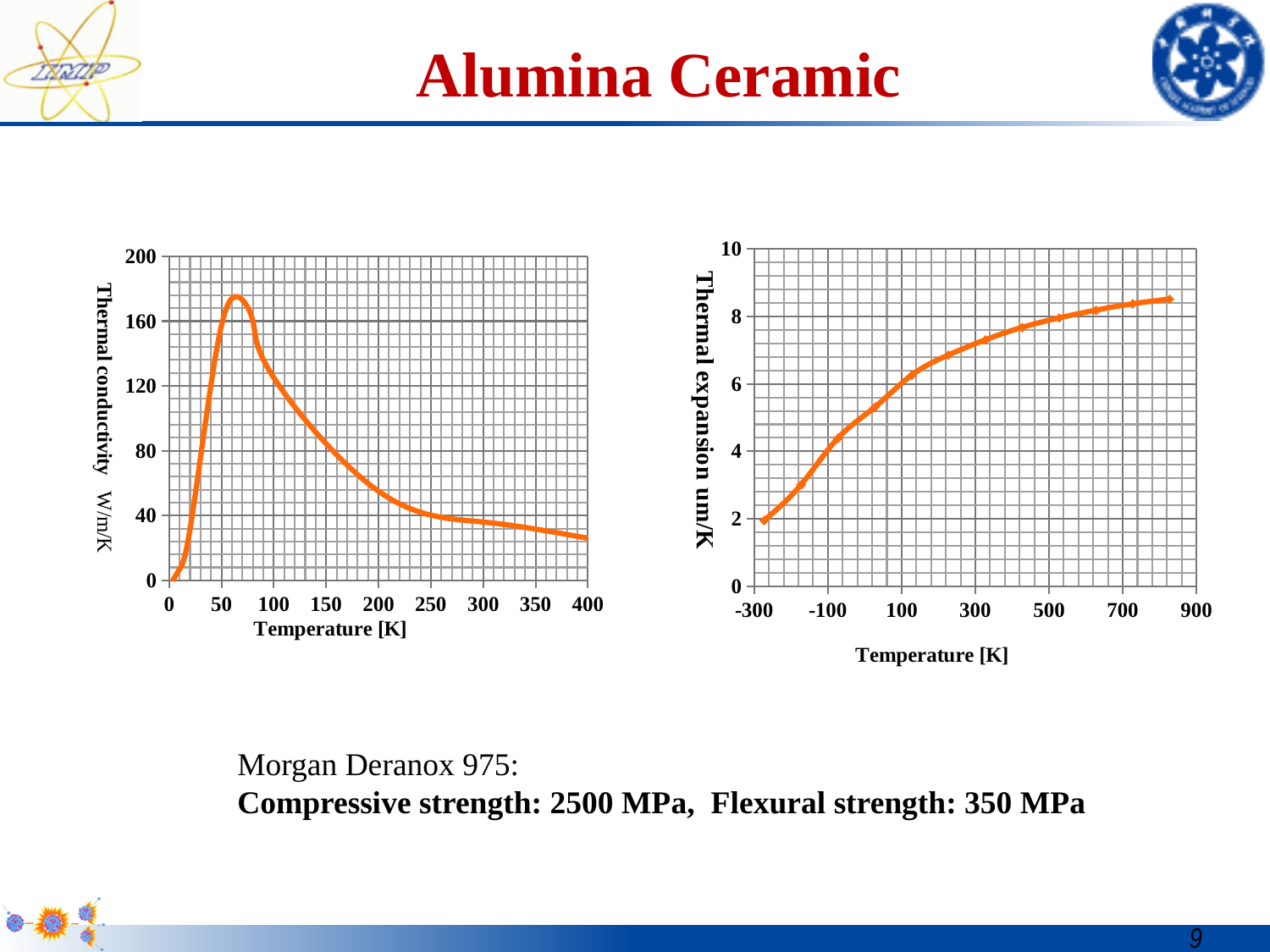
In the left chart, is the peak thermal conductivity greater or less than 160 W/m/K? greater In the right chart, is the thermal expansion at -100 K greater or less than 6 um/K? less In the left chart, is the thermal conductivity at 200 K greater or less than 80 W/m/K? less What is the x-axis label of the left chart? Temperature [K] What kind of chart is the left chart showing thermal conductivity? line chart In the left chart, does thermal conductivity rise or fall as temperature increases from 100 K to 400 K? fall What is the y-axis label of the right chart? Thermal expansion um/K In the right chart, does thermal expansion rise or fall as temperature increases from -300 K to 900 K? rise What kind of chart is the right chart showing thermal expansion? line chart